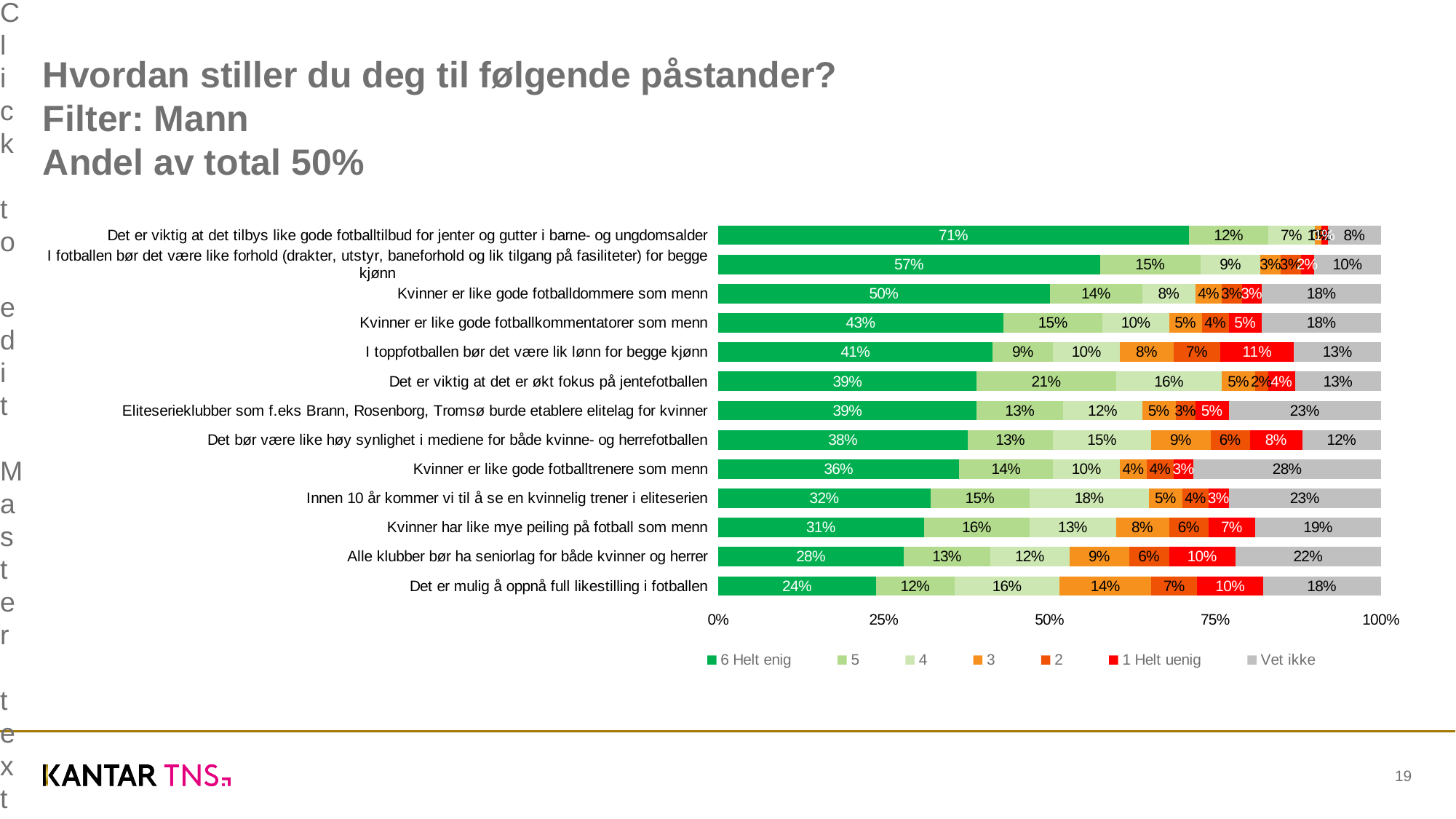
What type of chart is shown on the slide? Stacked bar chart What is the "5" value for "Det er viktig at det er økt fokus på jentefotballen"? 21% What is the "Vet ikke" value for "Kvinner er like gode fotballtrenere som menn"? 28% Which has a larger "Vet ikke" share: "Alle klubber bør ha seniorlag for både kvinner og herrer" or "Kvinner har like mye peiling på fotball som menn"? Alle klubber bør ha seniorlag for både kvinner og herrer What is the difference between the "6 Helt enig" values for "Kvinner er like gode fotballdommere som menn" and "Kvinner er like gode fotballkommentatorer som menn"? 7% What is the "1 Helt uenig" value for "I toppfotballen bør det være lik lønn for begge kjønn"? 11% What is the "3" value for "Det er mulig å oppnå full likestilling i fotballen"? 14% Which statement has the lowest "6 Helt enig" share? Det er mulig å oppnå full likestilling i fotballen What percentage of respondents answered "6 Helt enig" to "Det er viktig at det tilbys like gode fotballtilbud for jenter og gutter i barne- og ungdomsalder"? 71% How many statements (categories) are shown in the chart? 13 How many series does the legend list? 7 Which statement has the highest "6 Helt enig" share? Det er viktig at det tilbys like gode fotballtilbud for jenter og gutter i barne- og ungdomsalder